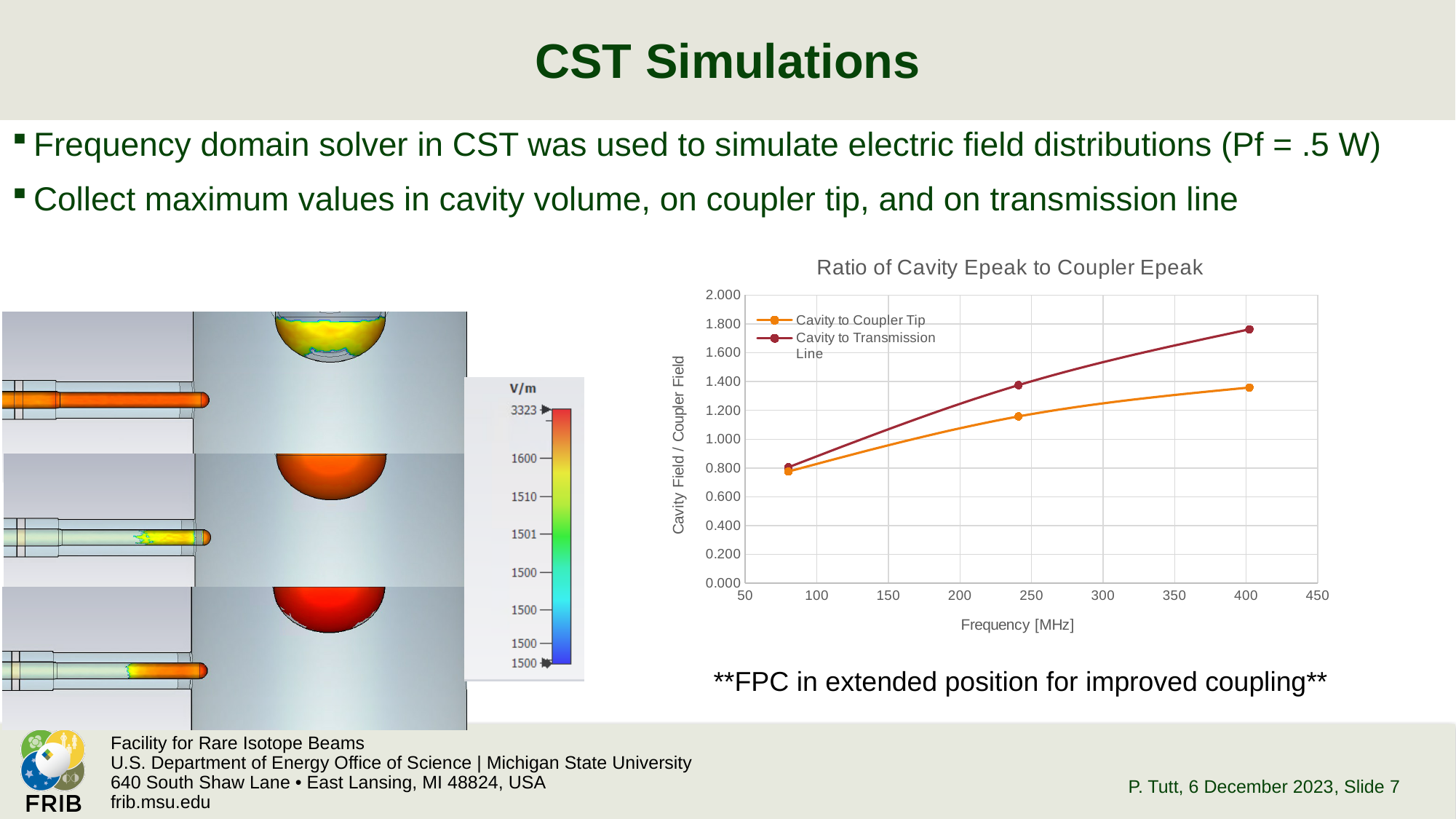
Is the value of the Cavity to Transmission Line series at its rightmost point (around 400 MHz) greater or less than 1.600? greater Does the Cavity to Transmission Line series rise or fall as frequency increases? rise At the rightmost plotted frequency (around 400 MHz), which series has the higher value: Cavity to Coupler Tip or Cavity to Transmission Line? Cavity to Transmission Line What is the title of the chart on the slide? Ratio of Cavity Epeak to Coupler Epeak What kind of chart is shown on the slide? line chart What is the label of the x axis of the chart? Frequency [MHz] Is the value of the Cavity to Coupler Tip series at its rightmost point (around 400 MHz) greater or less than 1.200? greater How many series does the chart's legend list? 2 How many data points are plotted for the Cavity to Coupler Tip series? 3 Is the value of the Cavity to Coupler Tip series at its leftmost point (around 80 MHz) greater or less than 1.000? less Does the Cavity to Coupler Tip series rise or fall as frequency increases? rise